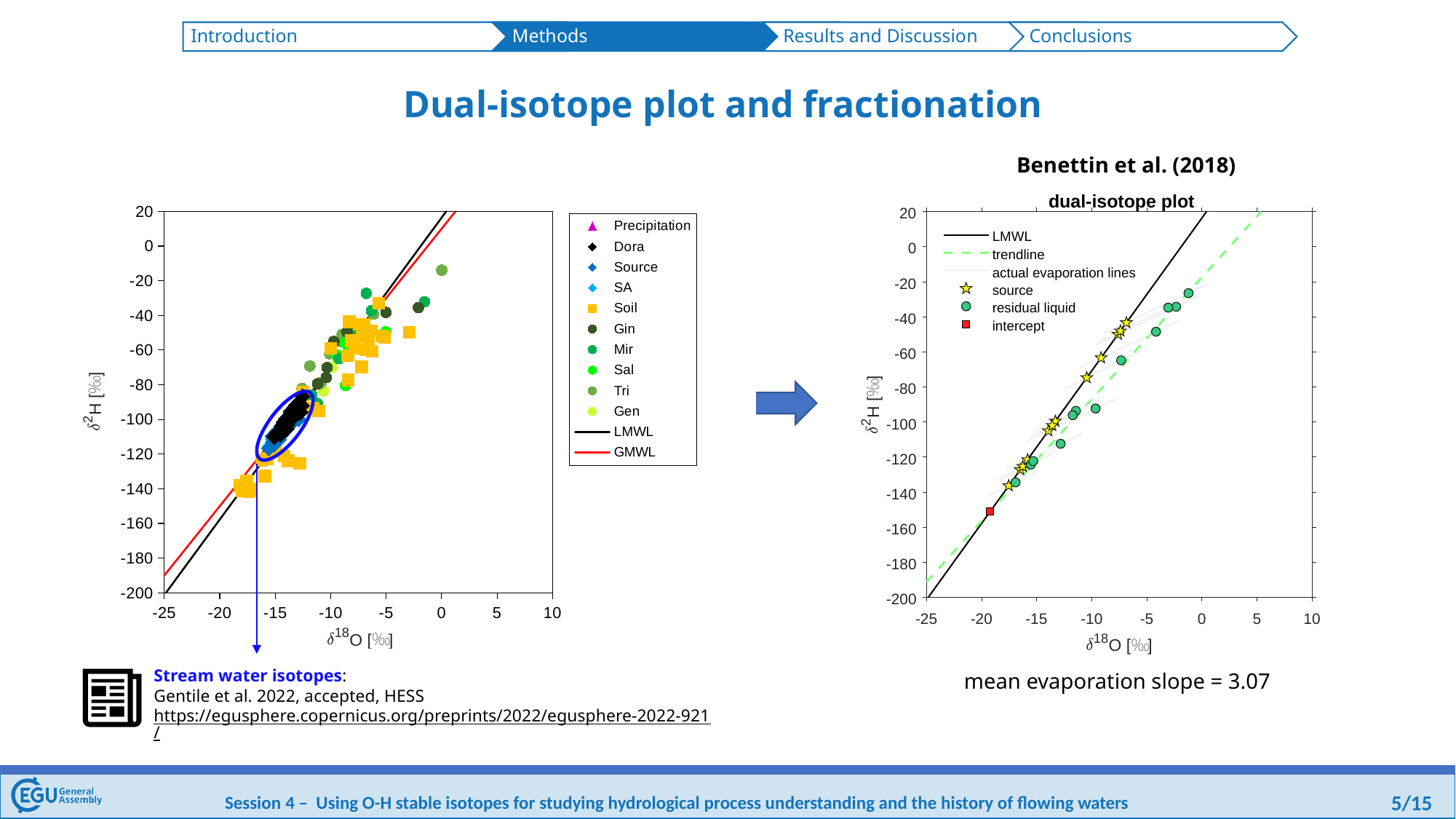
In the right chart titled 'dual-isotope plot', is the δ18O value of the intercept point greater or less than -15? less In the right chart titled 'dual-isotope plot', which legend entry is shown as a green dashed line? trendline What kind of chart is the left chart on the slide? scatter plot How many entries does the legend of the right chart titled 'dual-isotope plot' list? 6 What kind of chart is the right chart titled 'dual-isotope plot'? scatter plot In the left chart, what colour is the GMWL line? red In the right chart titled 'dual-isotope plot', is the δ2H value of the intercept point greater or less than -100? less What is the mean evaporation slope stated below the right chart? 3.07 In the right chart titled 'dual-isotope plot', do the residual liquid points rise or fall in δ2H as δ18O increases? rise In the left chart, is the δ2H value of the highest Tri point greater or less than -40? greater How many entries does the legend of the left chart list? 12 In the left chart, do the δ2H values of the data points rise or fall as δ18O increases along the x axis? rise